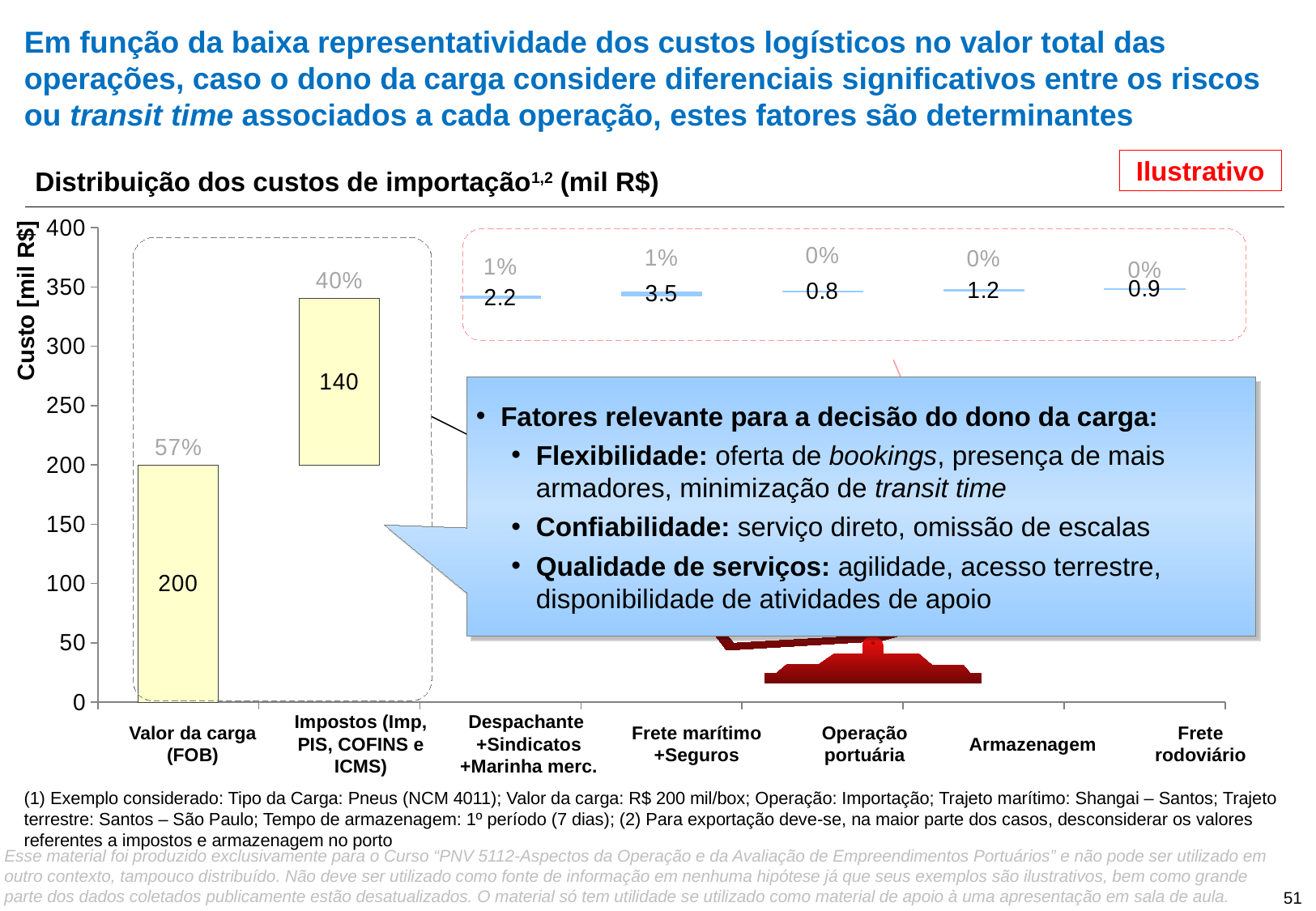
What is the value for Valor da carga (FOB)? 200 What percentage is shown above the Valor da carga (FOB) bar? 57% Which category has the lowest value? Operação portuária Which is larger, the value for Frete marítimo +Seguros or the value for Despachante +Sindicatos +Marinha merc.? Frete marítimo +Seguros What is the value for Armazenagem? 1.2 How many categories are shown on the x axis? 7 What is the value for Frete marítimo +Seguros? 3.5 What kind of chart is shown on the slide? bar chart Which category has the highest value? Valor da carga (FOB) What is the label of the y axis? Custo [mil R$] What is the value for Impostos (Imp, PIS, COFINS e ICMS)? 140 What is the difference between the values for Valor da carga (FOB) and Impostos (Imp, PIS, COFINS e ICMS)? 60